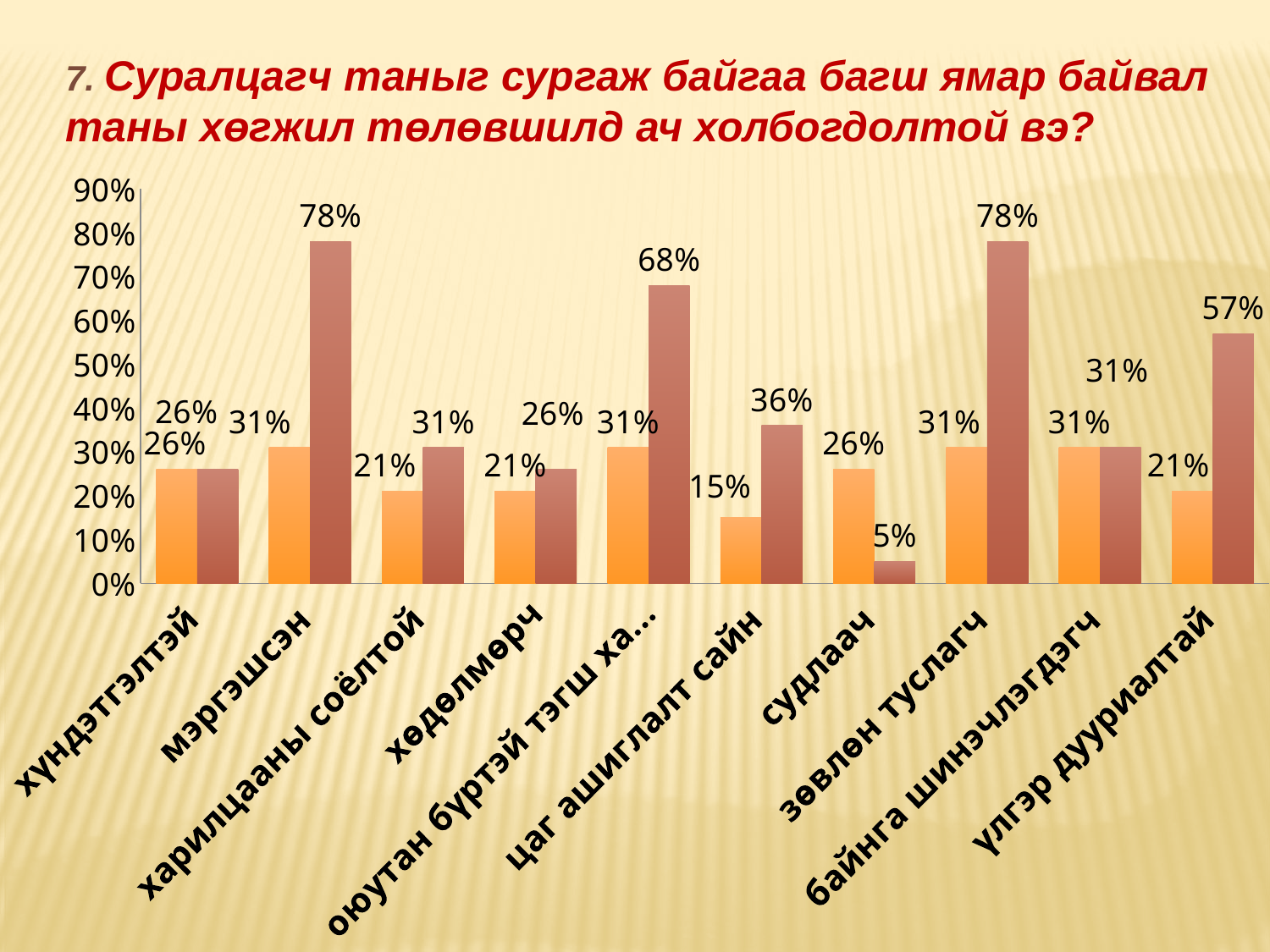
What is the difference between the brown bar and the orange bar for 'мэргэшсэн'? 47% What kind of chart is shown on the slide? bar chart What is the value of the brown bar for 'судлаач'? 5% How many categories are shown on the x axis of the chart? 10 Which is larger for 'судлаач', the orange bar or the brown bar? the orange bar Is the brown bar for 'зөвлөн туслагч' greater or less than 70%? greater Which category has the lowest orange bar? цаг ашиглалт сайн Which category has the lowest brown bar? судлаач What is the difference between the brown bar and the orange bar for 'үлгэр дууриалтай'? 36% What is the value of the brown bar for 'оюутан бүртэй тэгш ха...'? 68% What is the value of the orange bar for 'цаг ашиглалт сайн'? 15% What is the value of the brown bar for 'үлгэр дууриалтай'? 57%